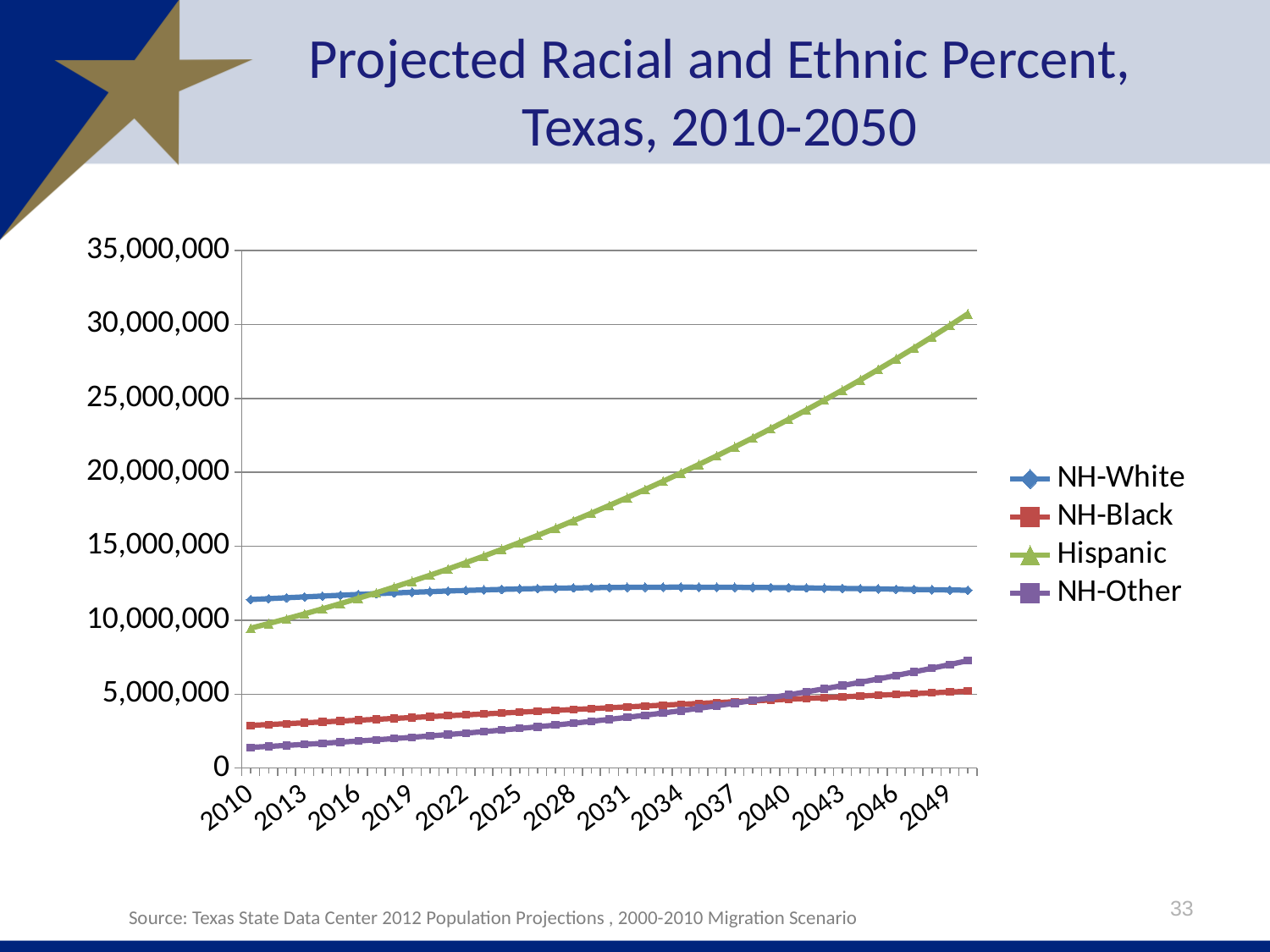
Is the value for NH-White in 2010 greater or less than 10,000,000? greater Which series has the lowest value in 2010? NH-Other Is the value for Hispanic in 2050 greater or less than 25,000,000? greater Which is larger in 2050, Hispanic or NH-White? Hispanic How many series does the legend list? 4 Does the NH-Other series rise or fall from 2010 to 2050? rise What kind of chart is shown on the slide? line chart Does the Hispanic series rise or fall from 2010 to 2050? rise Which series has the highest value in 2050? Hispanic Which series is plotted with the green line? Hispanic Which is larger in 2010, NH-Black or NH-Other? NH-Black What is the title of the chart? Projected Racial and Ethnic Percent, Texas, 2010-2050